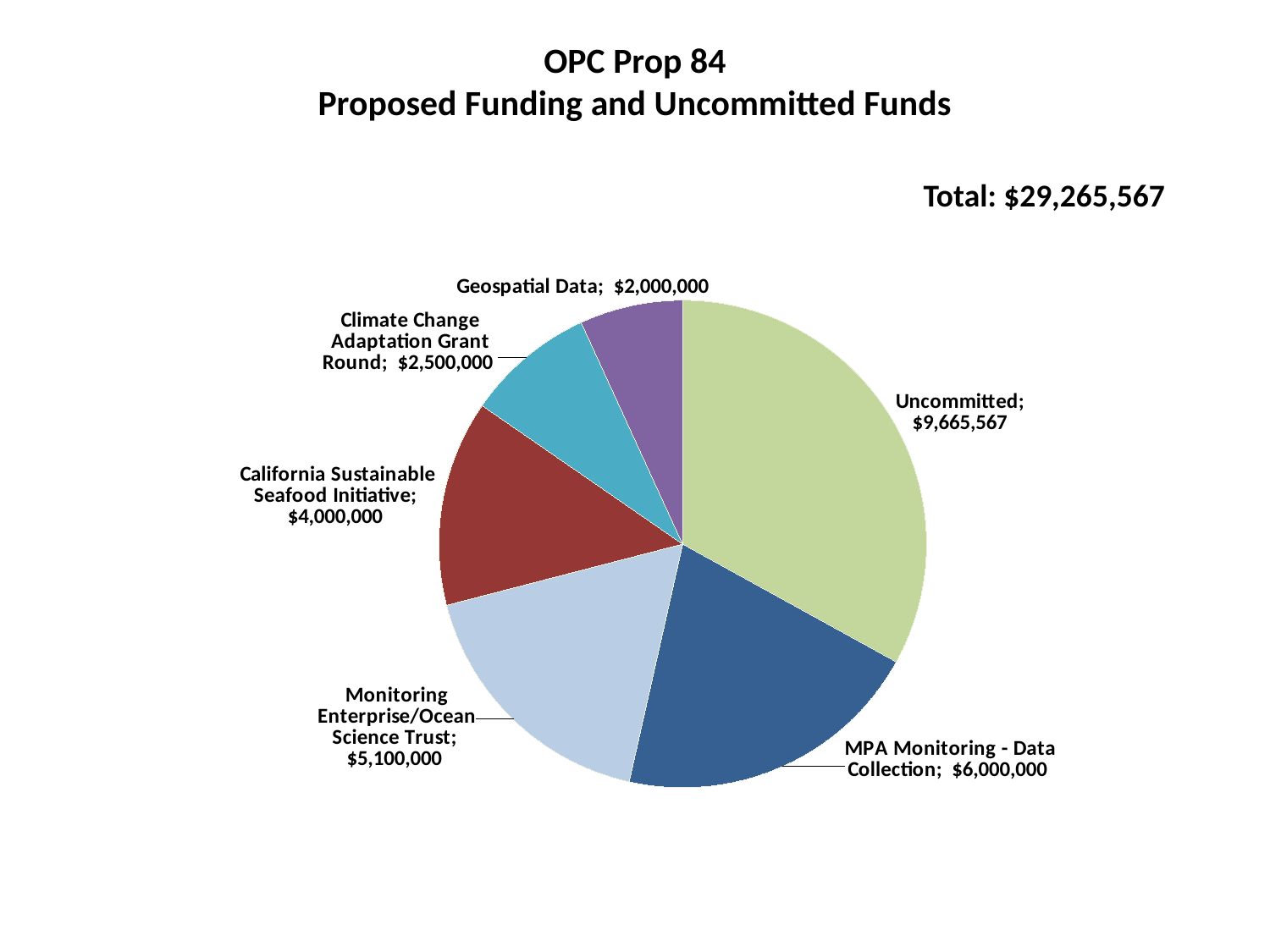
Which is larger, California Sustainable Seafood Initiative or Climate Change Adaptation Grant Round? California Sustainable Seafood Initiative Which slice of the pie is the smallest? Geospatial Data What is the difference between the Uncommitted slice and the MPA Monitoring - Data Collection slice? $3,665,567 How much larger is Monitoring Enterprise/Ocean Science Trust than California Sustainable Seafood Initiative? $1,100,000 What is the value of the Uncommitted slice? $9,665,567 How much funding is shown for MPA Monitoring - Data Collection? $6,000,000 What kind of chart is shown on the slide? Pie chart What is the value for the Climate Change Adaptation Grant Round slice? $2,500,000 What total amount is stated on the slide? $29,265,567 What is the title of the chart? OPC Prop 84 Proposed Funding and Uncommitted Funds How many slices does the pie chart have? 6 Which slice of the pie is the largest? Uncommitted